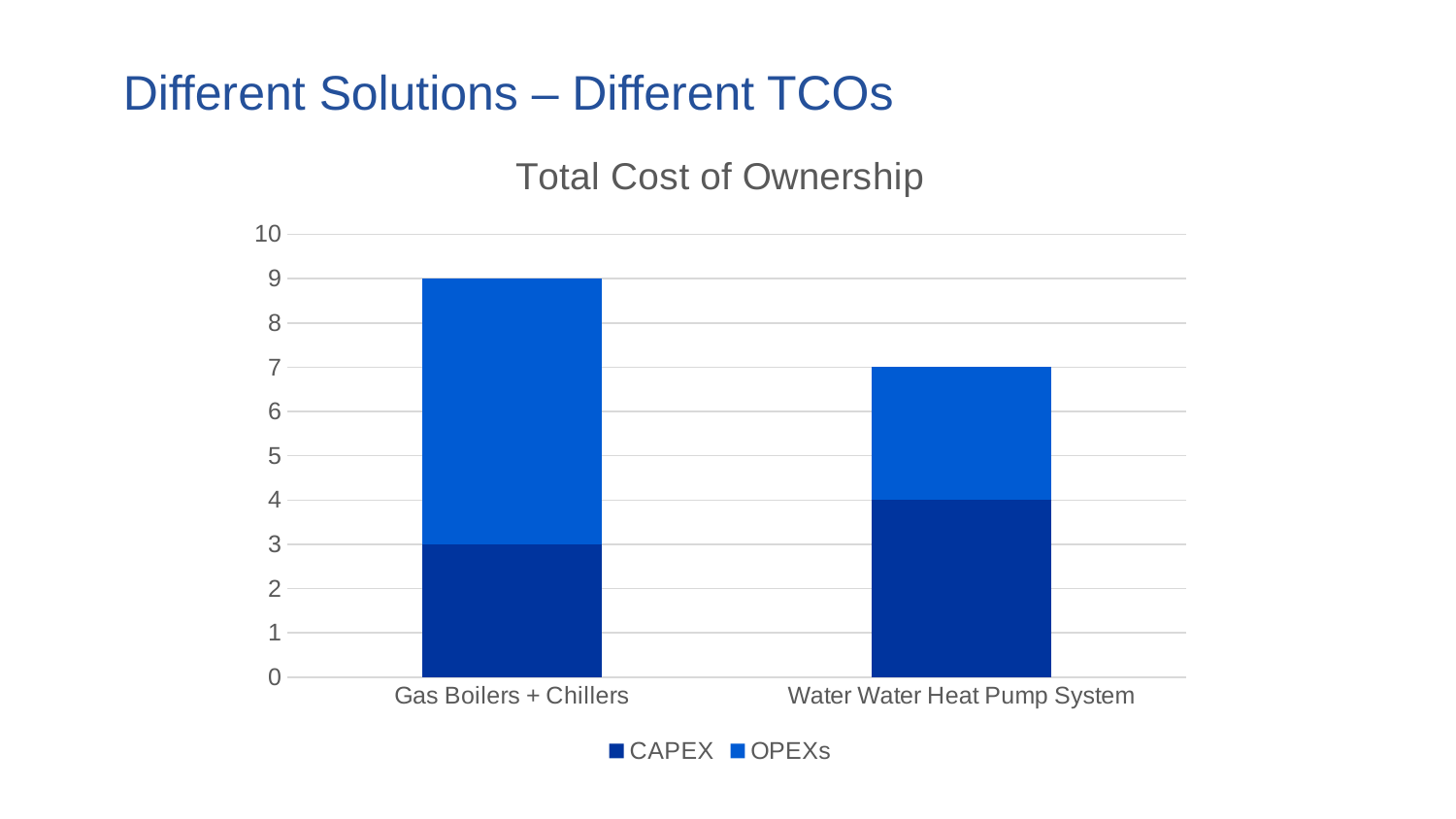
Which category has the higher total cost of ownership? Gas Boilers + Chillers What is the total height of the stacked bar for Water Water Heat Pump System? 7 How many series does the legend list? 2 What kind of chart is shown on the slide? Stacked bar chart What is the OPEXs value for Gas Boilers + Chillers? 6 What is the title of the chart? Total Cost of Ownership What is the CAPEX value for Water Water Heat Pump System? 4 What is the CAPEX value for Gas Boilers + Chillers? 3 Which series is shown in the darker blue colour? CAPEX How many categories are shown on the x axis? 2 What is the total height of the stacked bar for Gas Boilers + Chillers? 9 What is the difference between the total for Gas Boilers + Chillers and the total for Water Water Heat Pump System? 2